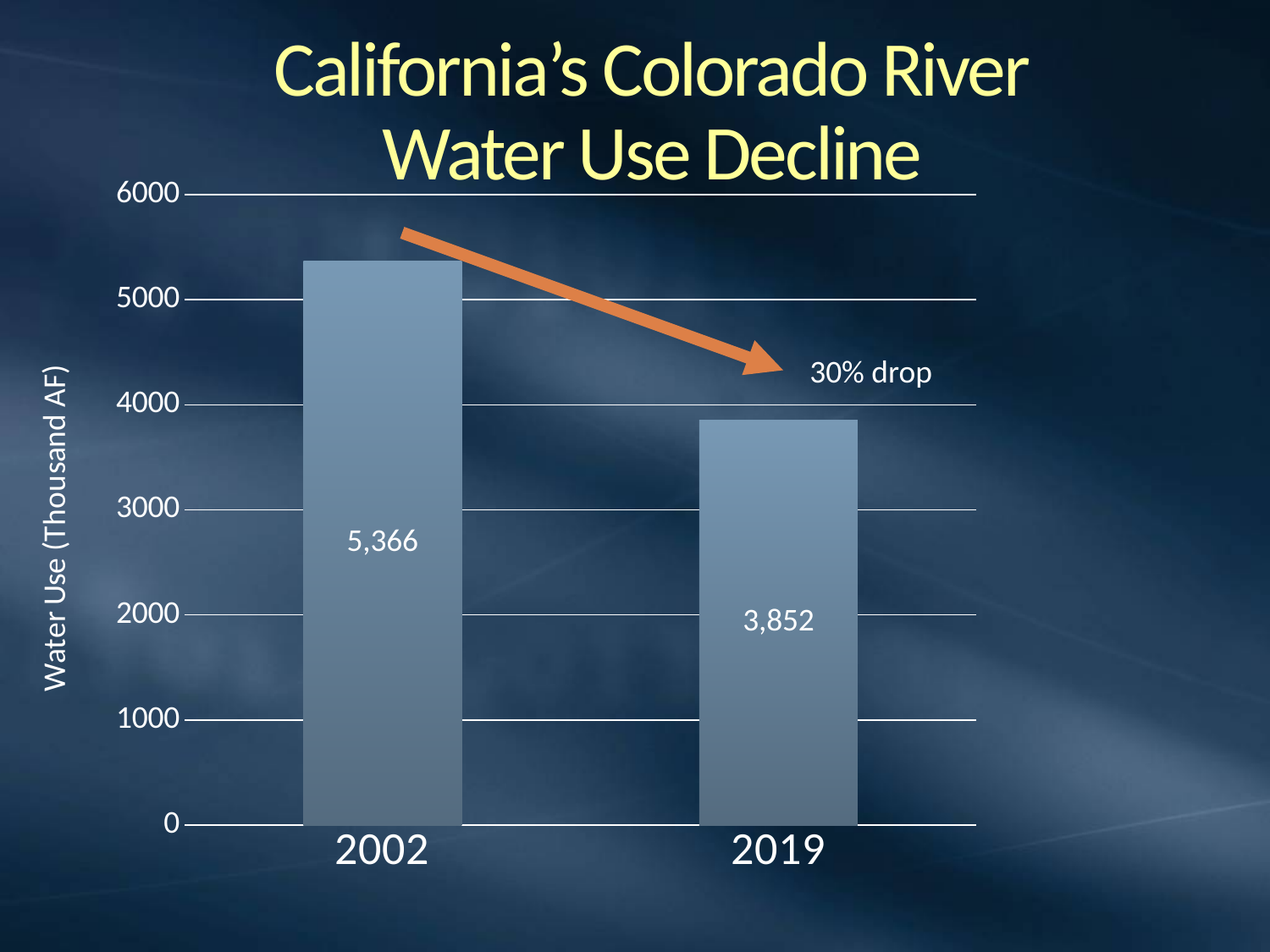
What kind of chart is shown on the slide? bar chart Does water use rise or fall from 2002 to 2019? fall What percentage drop is annotated on the chart? 30% drop Which year has the higher water use? 2002 Is the water use for 2002 greater or less than 5000? greater What is the water use value for 2019? 3,852 Which year has the lower water use? 2019 What is the difference in water use between 2002 and 2019? 1,514 What is the water use value for 2002? 5,366 How many years are shown on the chart? 2 What is the title of the chart? California's Colorado River Water Use Decline Is the water use for 2019 greater or less than 4000? less